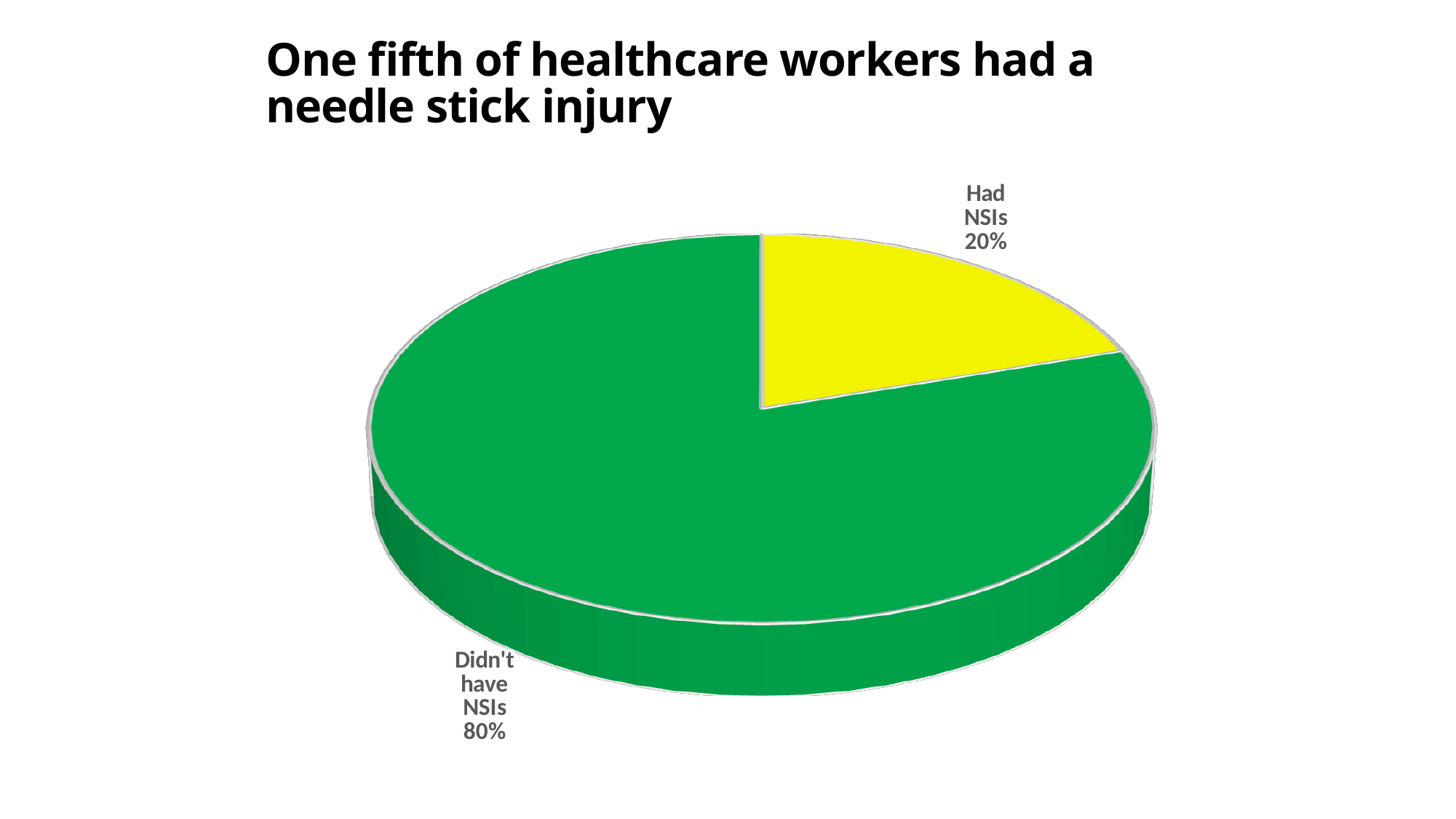
Which slice of the pie is the largest? Didn't have NSIs What colour is the 'Had NSIs' slice? Yellow What percentage of healthcare workers had NSIs? 20% What percentage of healthcare workers didn't have NSIs? 80% What share of the pie does the 'Had NSIs' slice represent? 20% How many slices does the pie chart have? 2 Which slice of the pie is the smallest? Had NSIs Which is larger: the share that had NSIs or the share that didn't have NSIs? Didn't have NSIs What is the difference in percentage points between the 'Didn't have NSIs' slice and the 'Had NSIs' slice? 60 What is the title of the chart? One fifth of healthcare workers had a needle stick injury What kind of chart is shown on the slide? Pie chart